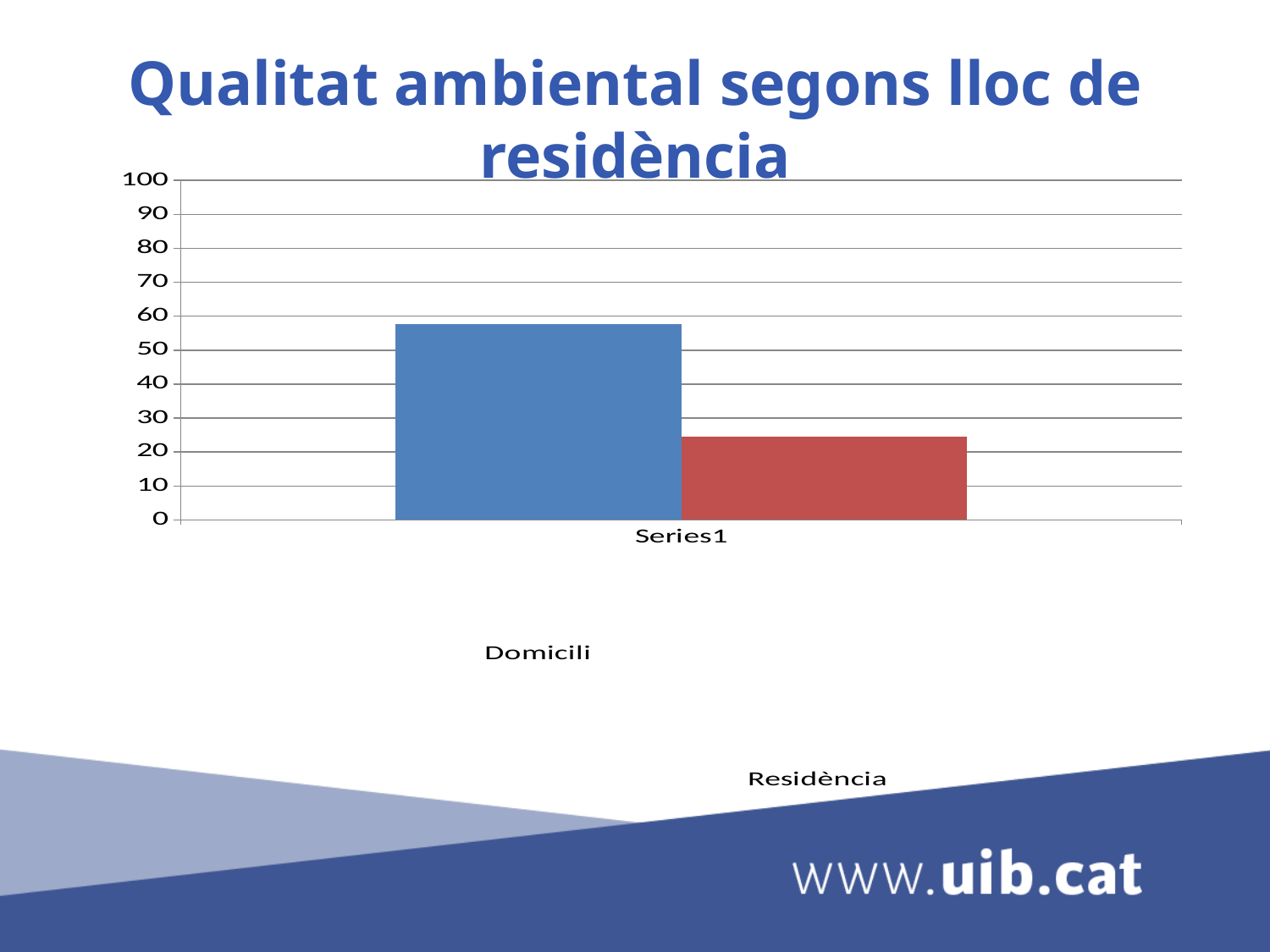
What colour is the bar for Residència? red How many series does the legend list? 2 Is the value for Residència greater or less than 30? less Which series has the highest bar in the chart? Domicili Which has the higher value, Domicili or Residència? Domicili What kind of chart is shown on the slide? bar chart Which series has the lowest bar in the chart? Residència Is the value for Domicili greater or less than 60? less What is the title of the chart on the slide? Qualitat ambiental segons lloc de residència How many bars are plotted in the chart? 2 Is the value for Residència greater or less than 20? greater